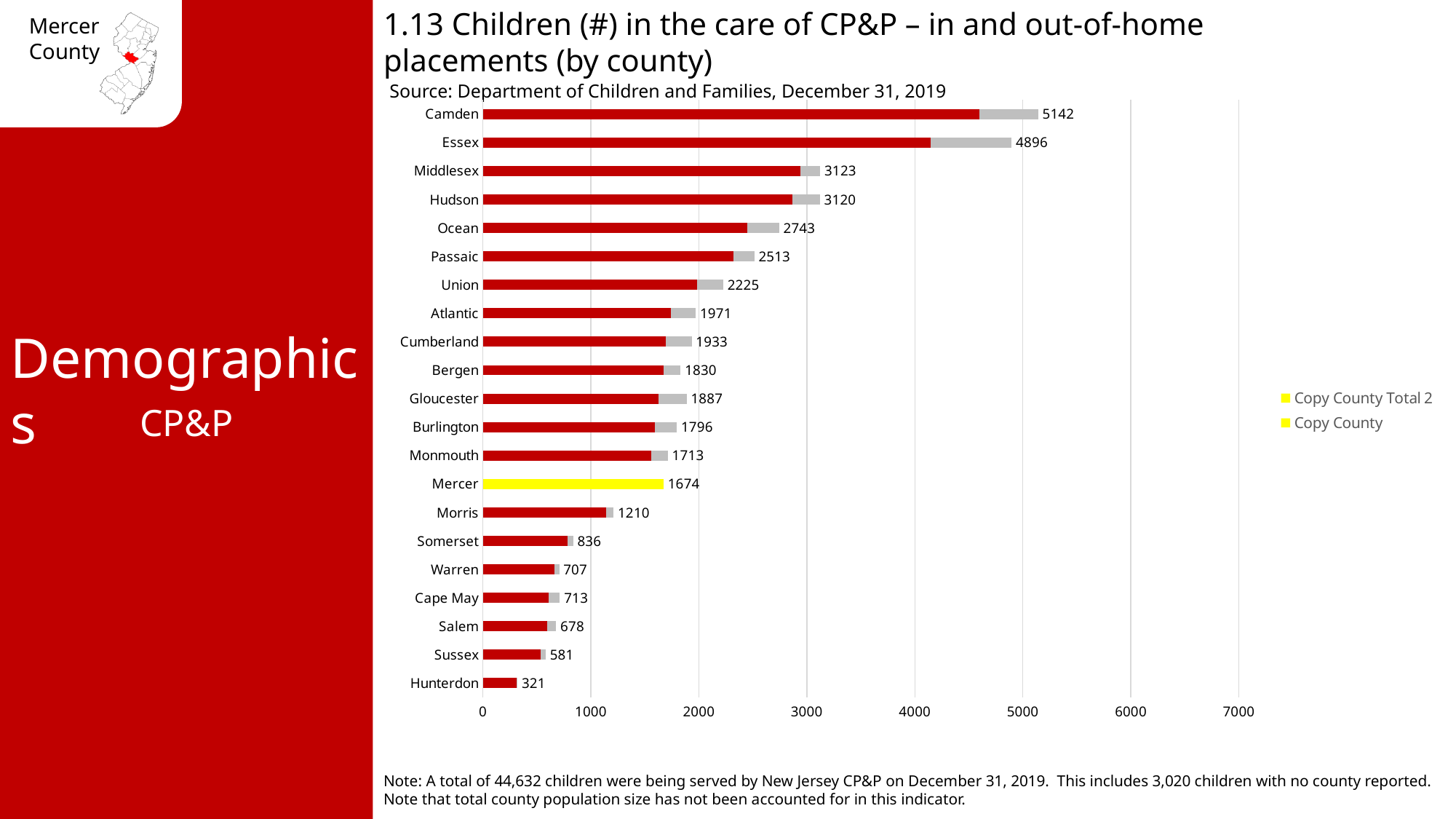
Which county has a larger value, Passaic or Union? Passaic Which county has the highest number of children in the care of CP&P? Camden Which county has the lowest number of children in the care of CP&P? Hunterdon How many entries does the legend list? 2 What type of chart is shown on the slide? Bar chart Is the value for Ocean County greater or less than 2000? greater What is the value shown for Hunterdon County? 321 What is the value shown for Mercer County? 1674 What is the total number of children in the care of CP&P for Camden County? 5142 What is the difference between the values for Mercer and Morris? 464 How many counties are shown in the chart? 21 What is the difference between the values for Camden and Essex? 246